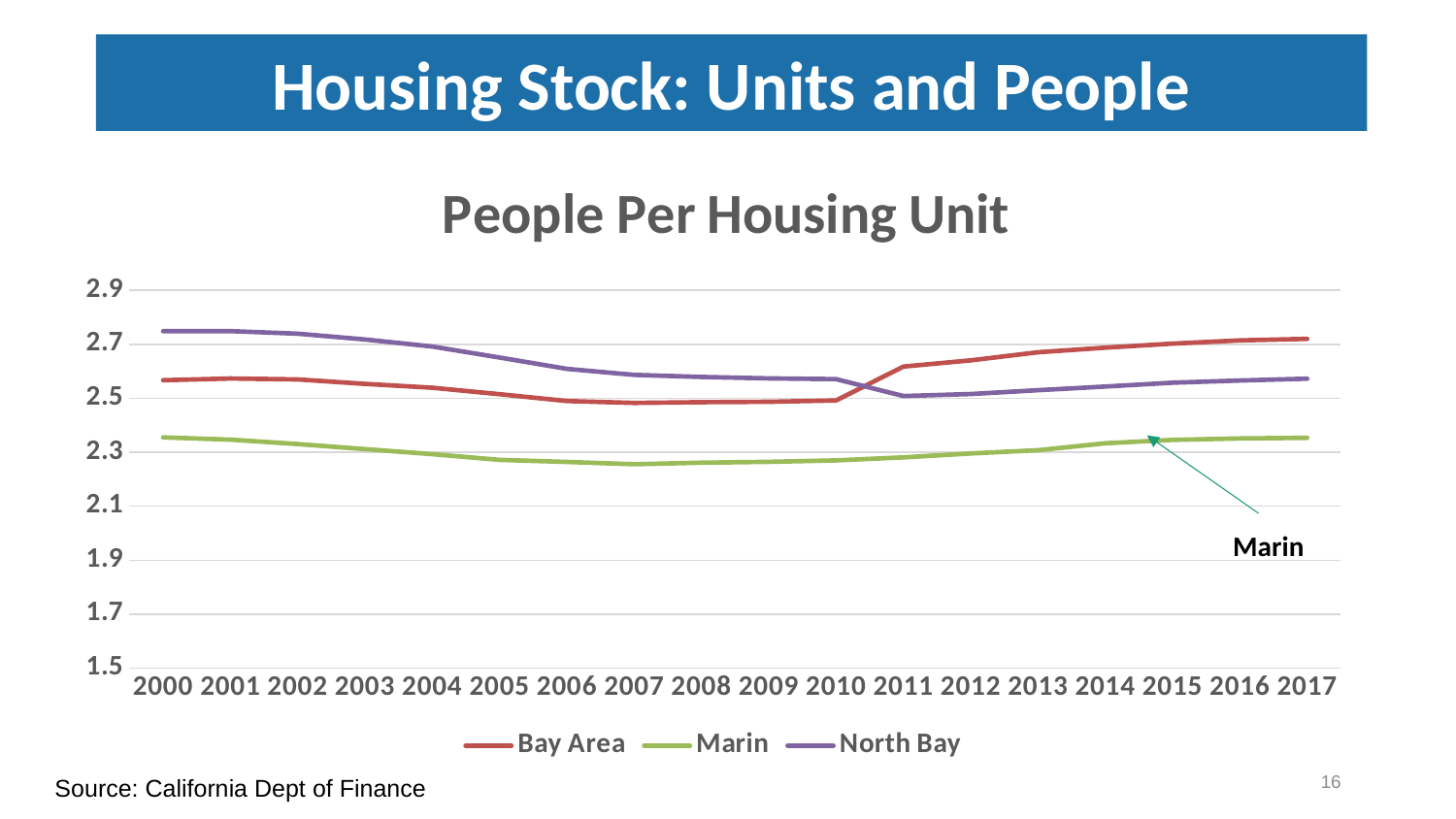
Which series has the highest people per housing unit in 2005? North Bay How many series does the legend list? 3 What kind of chart is shown on the slide? Line chart Which series has the lowest people per housing unit in 2010? Marin In 2017, which is larger: the value for Bay Area or the value for North Bay? Bay Area Does the Bay Area line rise or fall from 2010 to 2017? rise How many years are shown along the x axis? 18 Is the value for Marin in 2007 greater or less than 2.3? less What is the title of the chart? People Per Housing Unit Is the value for North Bay in 2000 greater or less than 2.7? greater In 2000, which is larger: the value for North Bay or the value for Bay Area? North Bay Which series is drawn in red? Bay Area